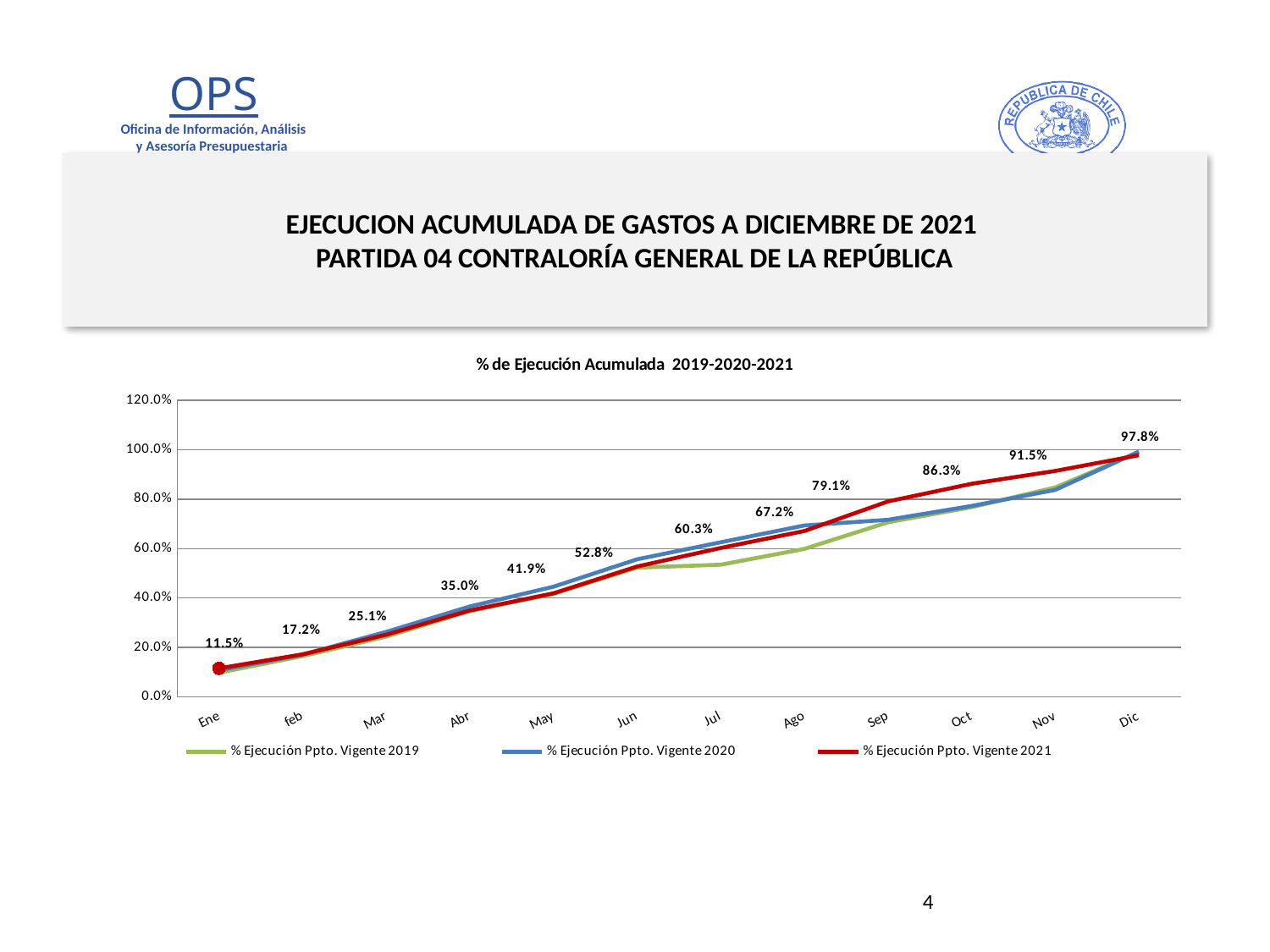
What is the value for % Ejecución Ppto. Vigente 2021 in Dic? 97.8% How many series does the legend list? 3 What is the chart's title? % de Ejecución Acumulada 2019-2020-2021 How many months are shown along the x axis? 12 What is the value for % Ejecución Ppto. Vigente 2021 in Ene? 11.5% What is the value for % Ejecución Ppto. Vigente 2021 in Jun? 52.8% Is the value for % Ejecución Ppto. Vigente 2019 in Ago greater or less than 80.0%? less Does the % Ejecución Ppto. Vigente 2021 series rise or fall from Ene to Dic? rise In which month is the % Ejecución Ppto. Vigente 2021 series lowest? Ene What is the difference between the % Ejecución Ppto. Vigente 2021 values for Sep and Ago? 11.9% In which month is the % Ejecución Ppto. Vigente 2021 series highest? Dic What type of chart is shown on the slide? line chart